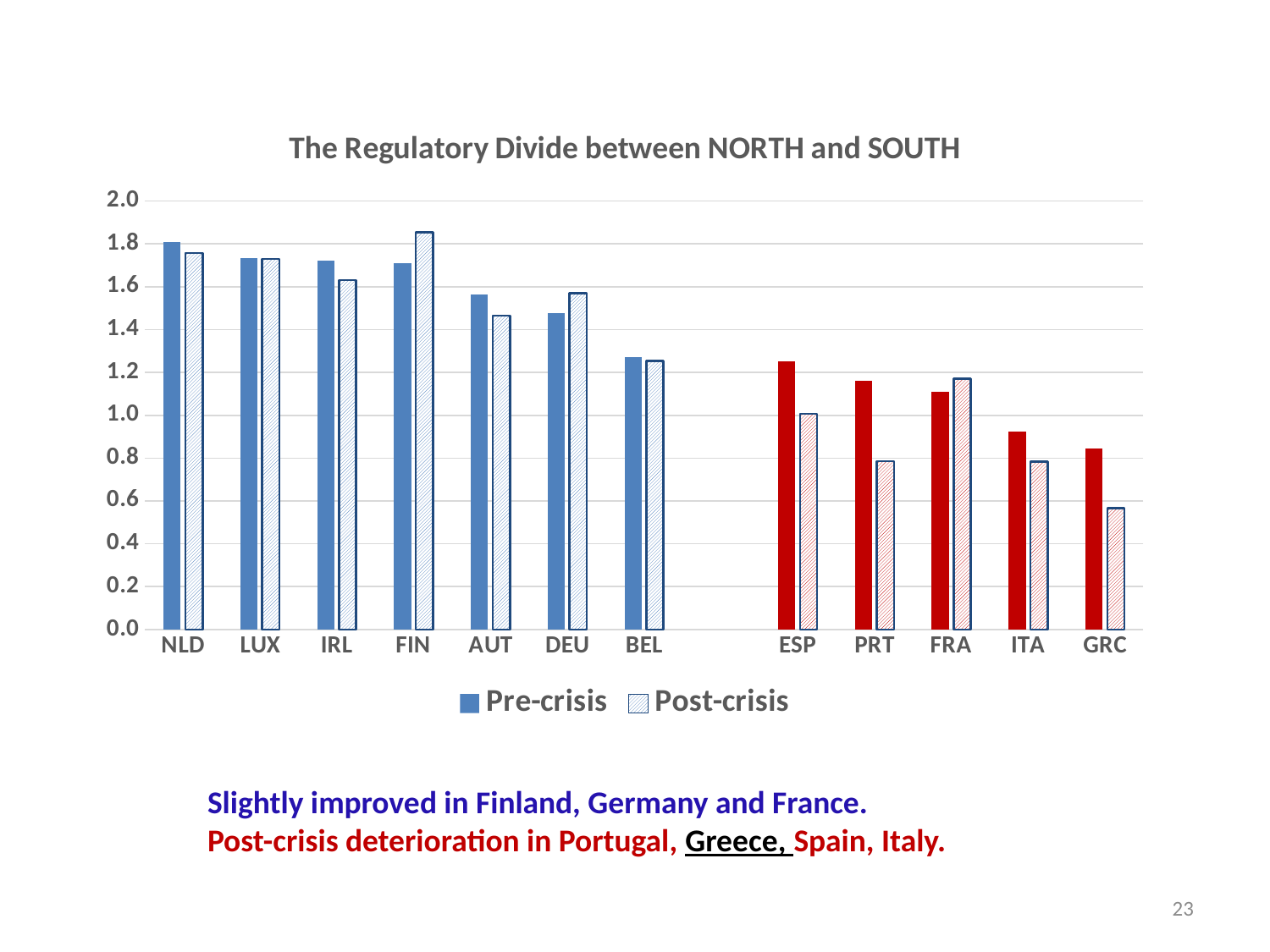
For FIN, which is larger: the Pre-crisis or the Post-crisis value? Post-crisis What is the title of the chart? The Regulatory Divide between NORTH and SOUTH Is the Pre-crisis value for NLD greater or less than 1.6? greater Is the Post-crisis value for PRT greater or less than 1.0? less Which country has the lowest Post-crisis value? GRC How many series does the legend list? 2 Which country has the highest Post-crisis value? FIN How many countries are shown on the x axis? 12 For ESP, which is larger: the Pre-crisis or the Post-crisis value? Pre-crisis Which country has the lowest Pre-crisis value? GRC Which country has the highest Pre-crisis value? NLD What kind of chart is shown on the slide? bar chart